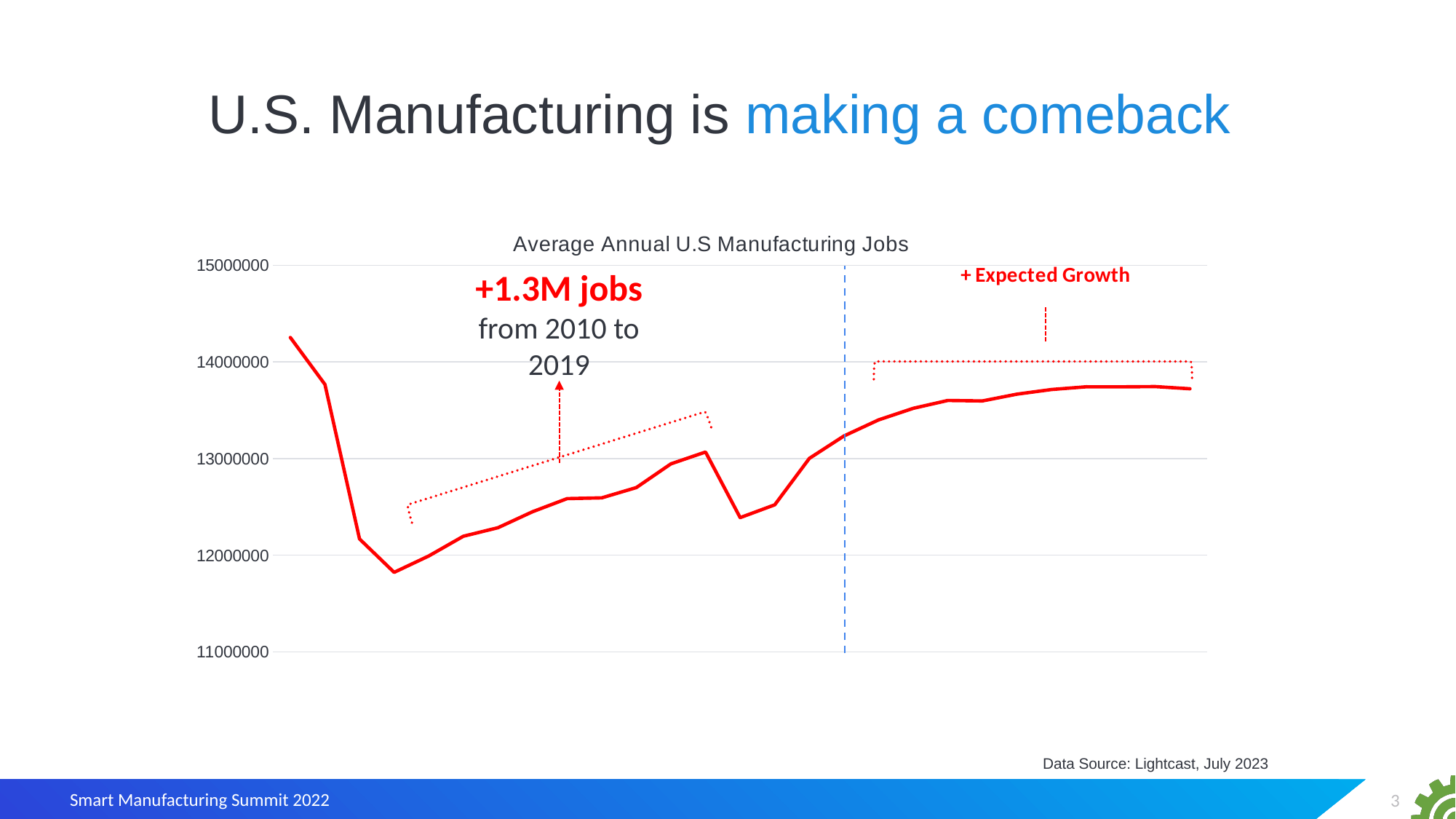
What is the highest value shown on the y axis? 15000000 Is the last (rightmost) point on the line greater or less than 13000000? greater Which is larger, the first point on the line or the last point on the line? the first point What is the title of the chart? Average Annual U.S Manufacturing Jobs What kind of chart is shown on the slide? line chart Is the first (leftmost) point on the line greater or less than 14000000? greater Does the line rise or fall over the section to the right of the dashed blue vertical line? rise How many lines (data series) are plotted in the chart? 1 Is the lowest point on the line greater or less than 12000000? less According to the annotation on the chart, how many jobs were added from 2010 to 2019? +1.3M jobs